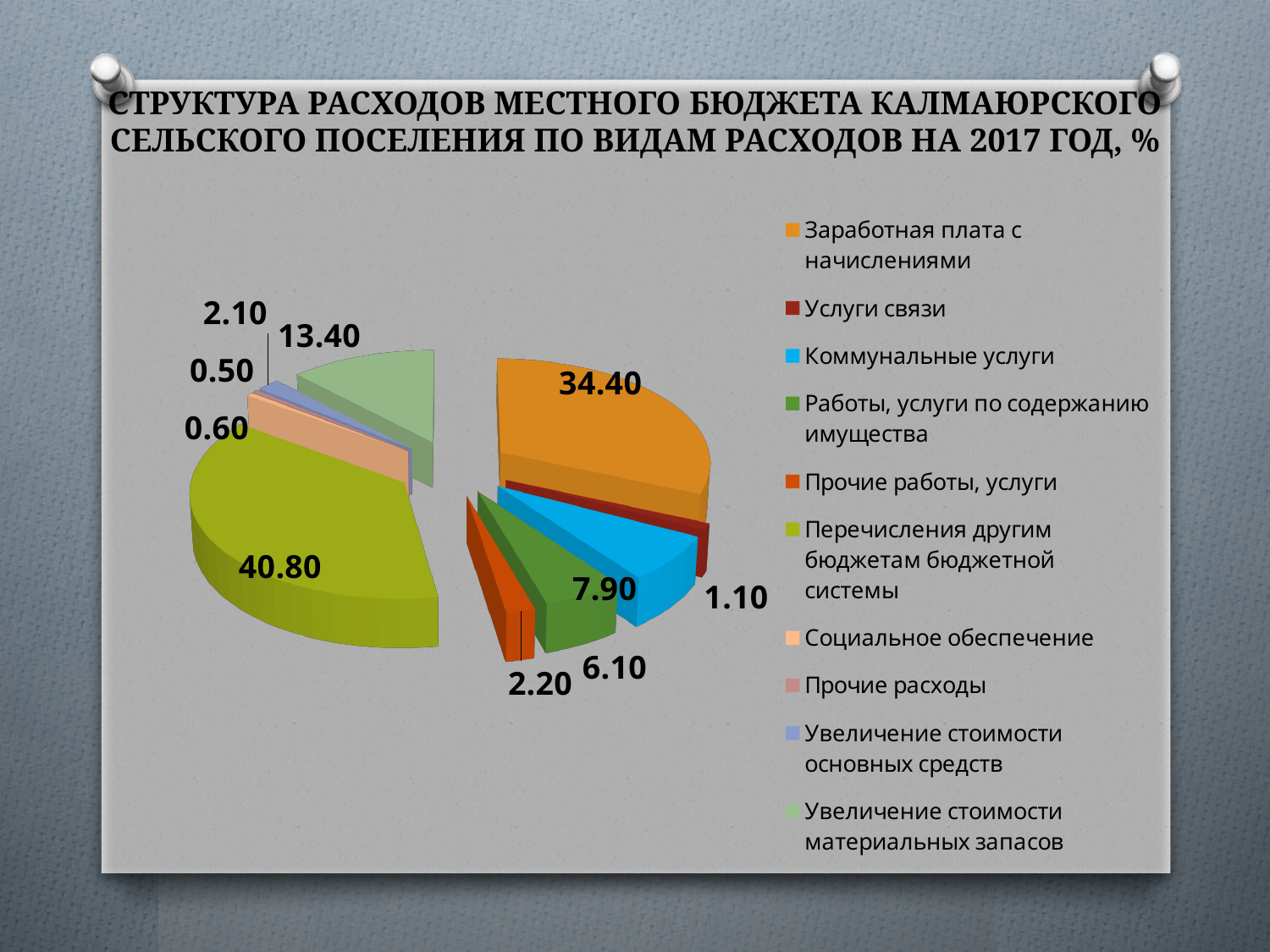
What type of chart is shown on the slide? pie chart What is the value for Услуги связи? 1.10 What colour is the slice for Заработная плата с начислениями? orange What is the value for Коммунальные услуги? 7.90 What is the value for Увеличение стоимости материальных запасов? 13.40 What is the value for Перечисления другим бюджетам бюджетной системы? 40.80 Which is larger: the value for Коммунальные услуги or the value for Работы, услуги по содержанию имущества? Коммунальные услуги Which category has the largest slice of the pie? Перечисления другим бюджетам бюджетной системы What is the value for Заработная плата с начислениями? 34.40 Which category has the smallest slice of the pie? Прочие расходы What is the difference between the values for Перечисления другим бюджетам бюджетной системы and Заработная плата с начислениями? 6.40 How many categories does the legend list? 10